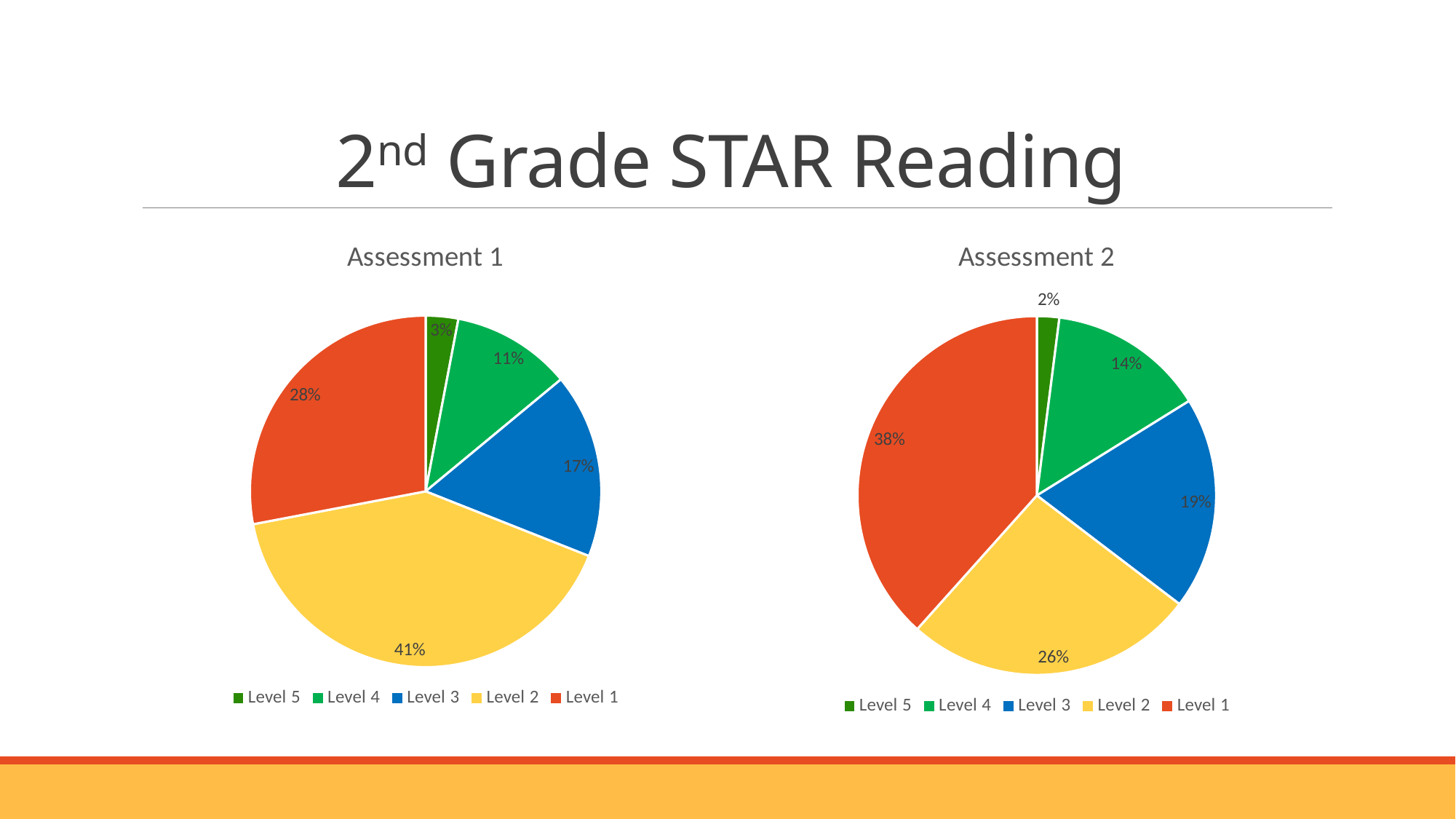
In the Assessment 1 chart, which level has the largest slice? Level 2 In the Assessment 1 chart, what percentage is Level 2? 41% In the Assessment 1 chart, what is the difference between the Level 2 and Level 1 percentages? 13% In the Assessment 2 chart, which level has the largest slice? Level 1 In the Assessment 1 chart, what colour is the Level 3 slice? Blue In the Assessment 2 chart, which is larger, Level 4 or Level 3? Level 3 In the Assessment 2 chart, what percentage is Level 1? 38% How many slices does the Assessment 1 chart have? 5 In the Assessment 1 chart, what percentage is Level 5? 3% In the Assessment 2 chart, which level has the smallest slice? Level 5 What kind of chart is the Assessment 2 chart? Pie chart In the Assessment 2 chart, what percentage is Level 3? 19%